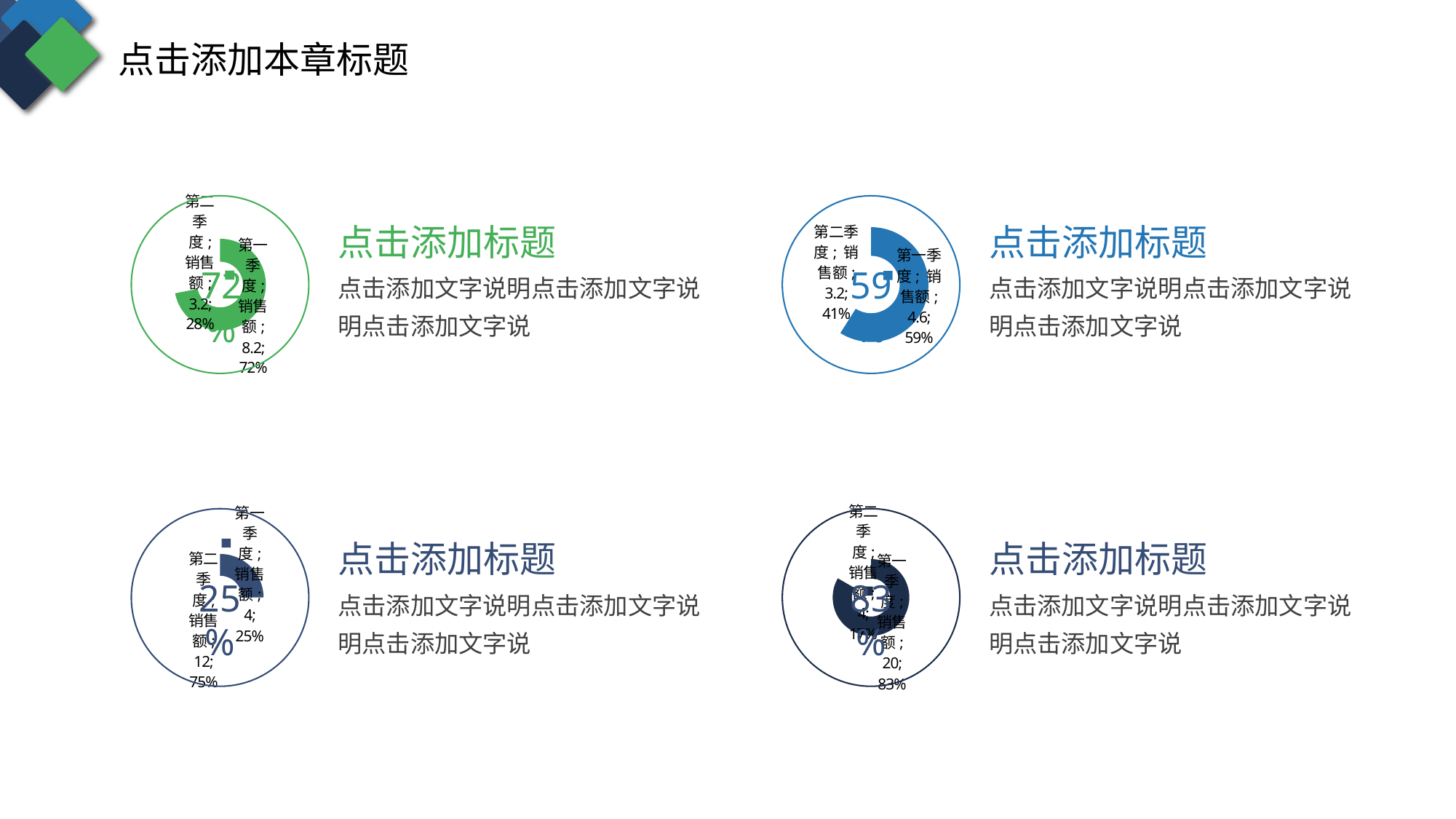
In the bottom-left chart, what is the value for 第二季度 销售额? 12 In the bottom-right chart, what percentage share does 第二季度 have? 17% In the top-left chart, which quarter has the smaller value? 第二季度 How many charts are shown on the slide? 4 In the bottom-right chart, what is the difference between the 第一季度 and 第二季度 values? 16 In the bottom-left chart, which quarter has the larger share? 第二季度 In the top-left chart, what percentage share does 第二季度 have? 28% In the top-right chart, what percentage share does 第一季度 have? 59% In the top-right chart, what is the value for 第二季度 销售额? 3.2 What kind of chart is the top-right chart? Doughnut chart In the top-left chart, what is the value for 第一季度 销售额? 8.2 In the bottom-right chart, what is the value for 第一季度 销售额? 20